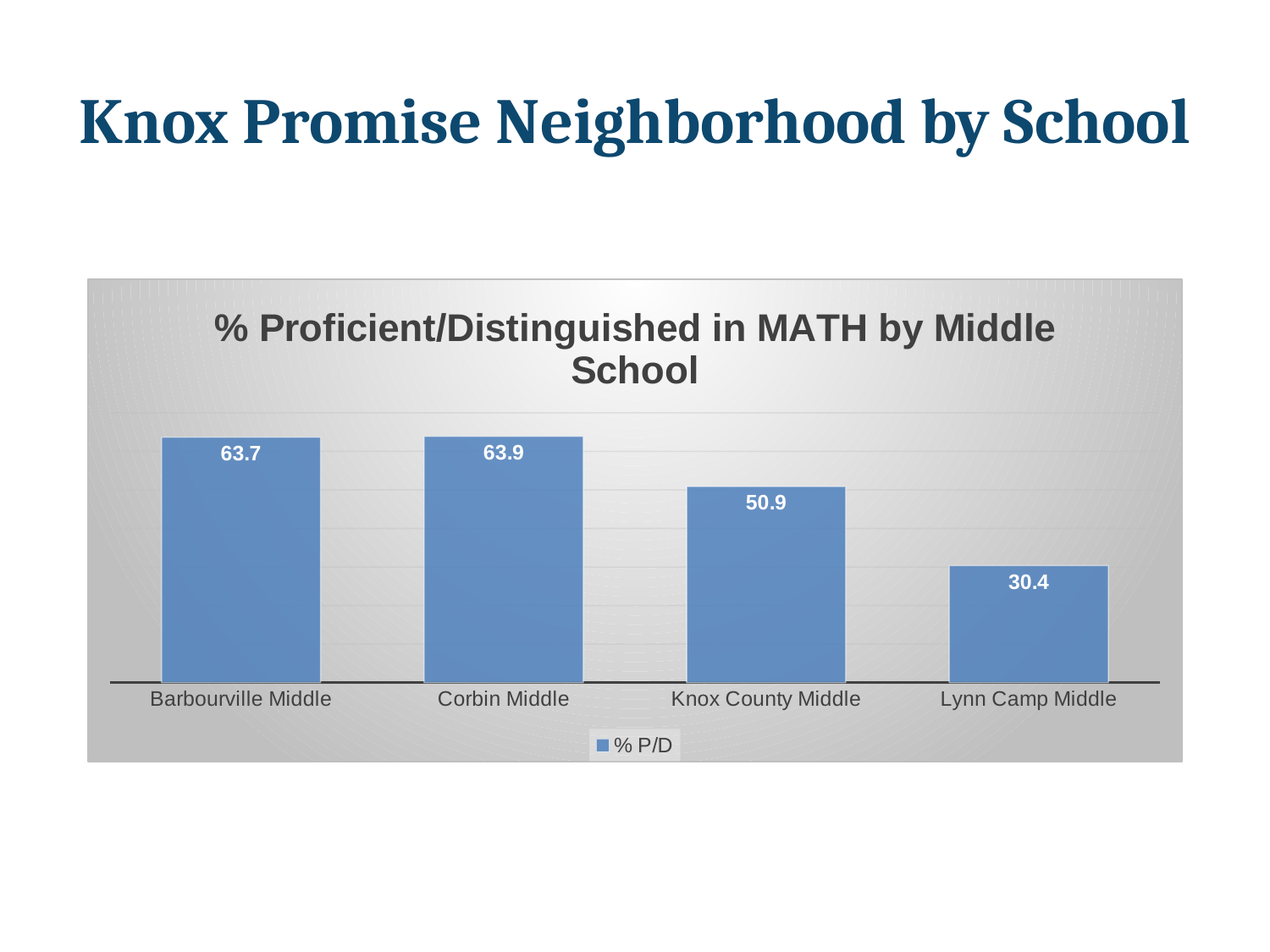
What is the % P/D value for Corbin Middle? 63.9 What is the title of the chart? % Proficient/Distinguished in MATH by Middle School What is the difference between the values for Knox County Middle and Lynn Camp Middle? 20.5 What kind of chart is shown on the slide? bar chart Which is larger, the value for Knox County Middle or the value for Lynn Camp Middle? Knox County Middle How many schools are shown in the chart? 4 What is the difference between the values for Corbin Middle and Knox County Middle? 13 What is the % P/D value for Barbourville Middle? 63.7 What is the % P/D value for Knox County Middle? 50.9 Which school has the lowest % Proficient/Distinguished in math? Lynn Camp Middle What is the % P/D value for Lynn Camp Middle? 30.4 How many series does the legend list? 1